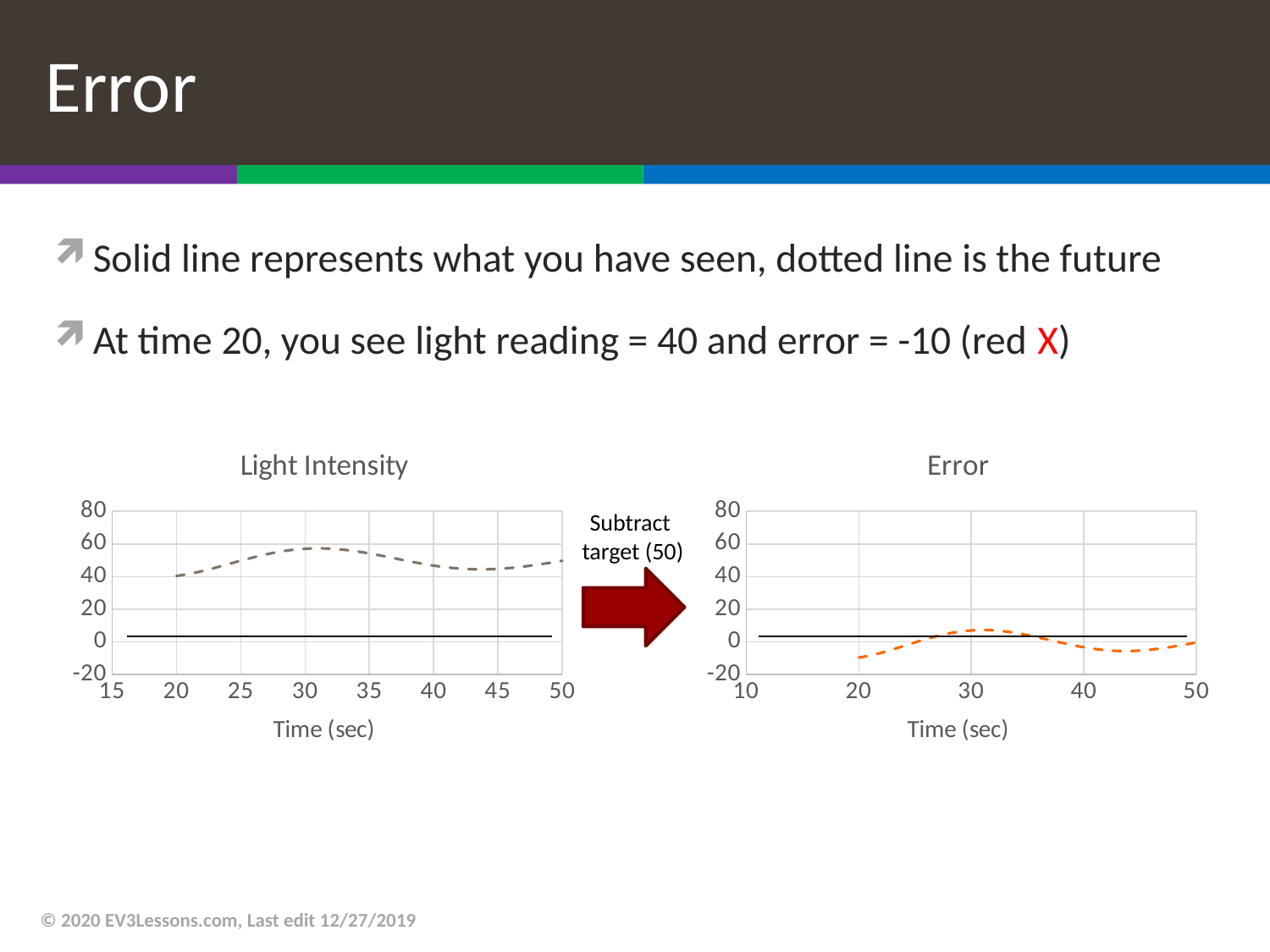
In the Light Intensity chart, what is the light reading at time 20? 40 In the Error chart, what is the error value at time 20? -10 In the Error chart, does the dotted line rise or fall between time 35 and time 45? fall What is the title of the chart on the left? Light Intensity What is the x-axis label on the Error chart? Time (sec) What kind of chart is the Light Intensity chart? line chart In the Error chart, is the value at time 30 greater or less than 0? greater In the Light Intensity chart, which is larger: the value at time 30 or the value at time 45? time 30 In the Error chart, is the value at time 45 greater or less than 0? less In the Light Intensity chart, is the value at time 45 greater or less than 60? less In the Light Intensity chart, does the dotted line rise or fall between time 20 and time 30? rise